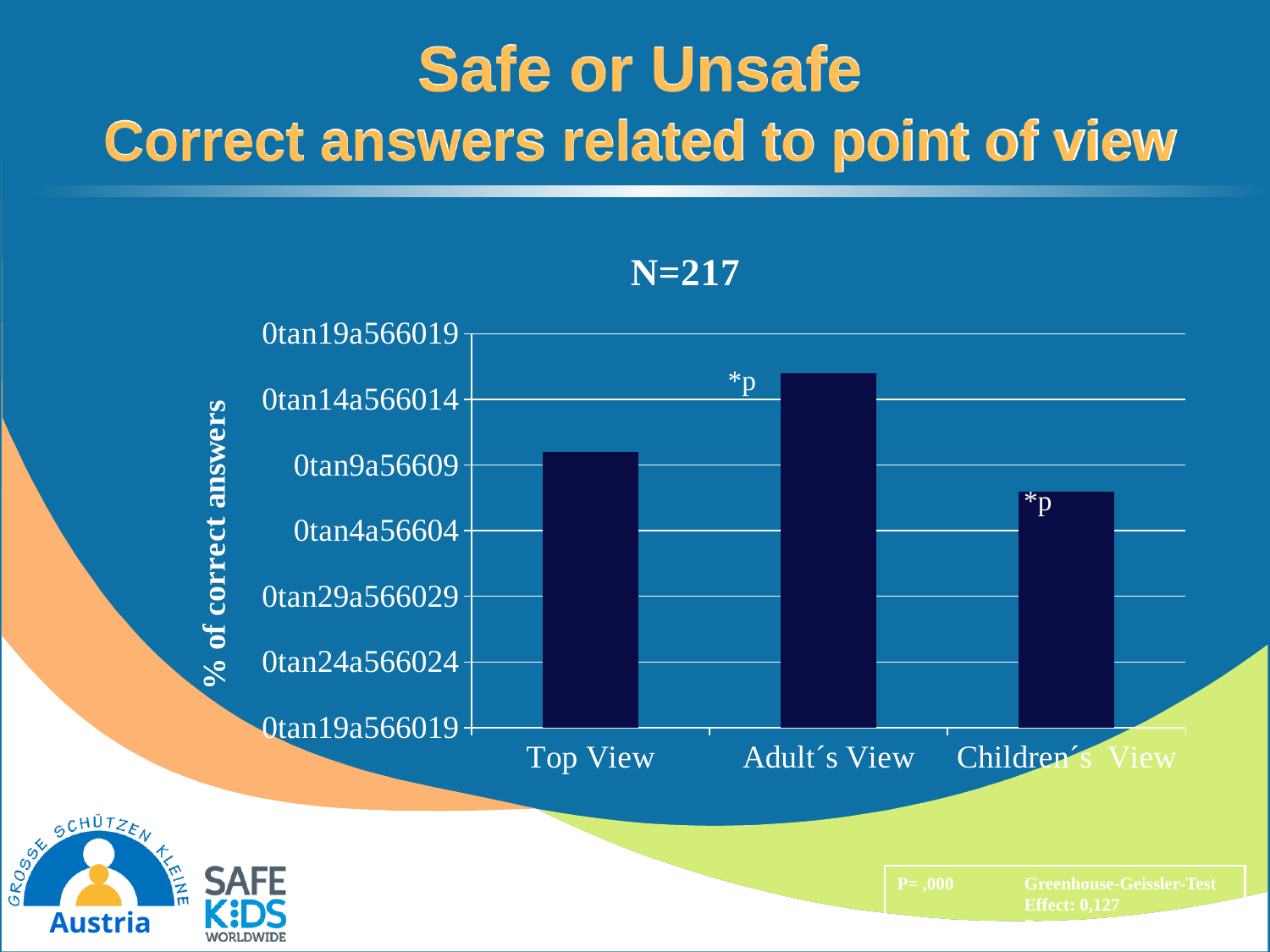
Do the bar values rise or fall from Top View to Adult´s View? rise Which has a higher value, Top View or Children´s View? Top View Do the bar values rise or fall from Adult´s View to Children´s View? fall Which has a lower value, Adult´s View or Children´s View? Children´s View Which has a higher value, Adult´s View or Top View? Adult´s View What is the label of the vertical axis of the chart? % of correct answers Which point of view has the highest percentage of correct answers? Adult´s View What kind of chart is shown on the slide? bar chart What is the title shown above the chart? N=217 Which point of view has the lowest percentage of correct answers? Children´s View How many categories are shown on the x axis of the chart? 3